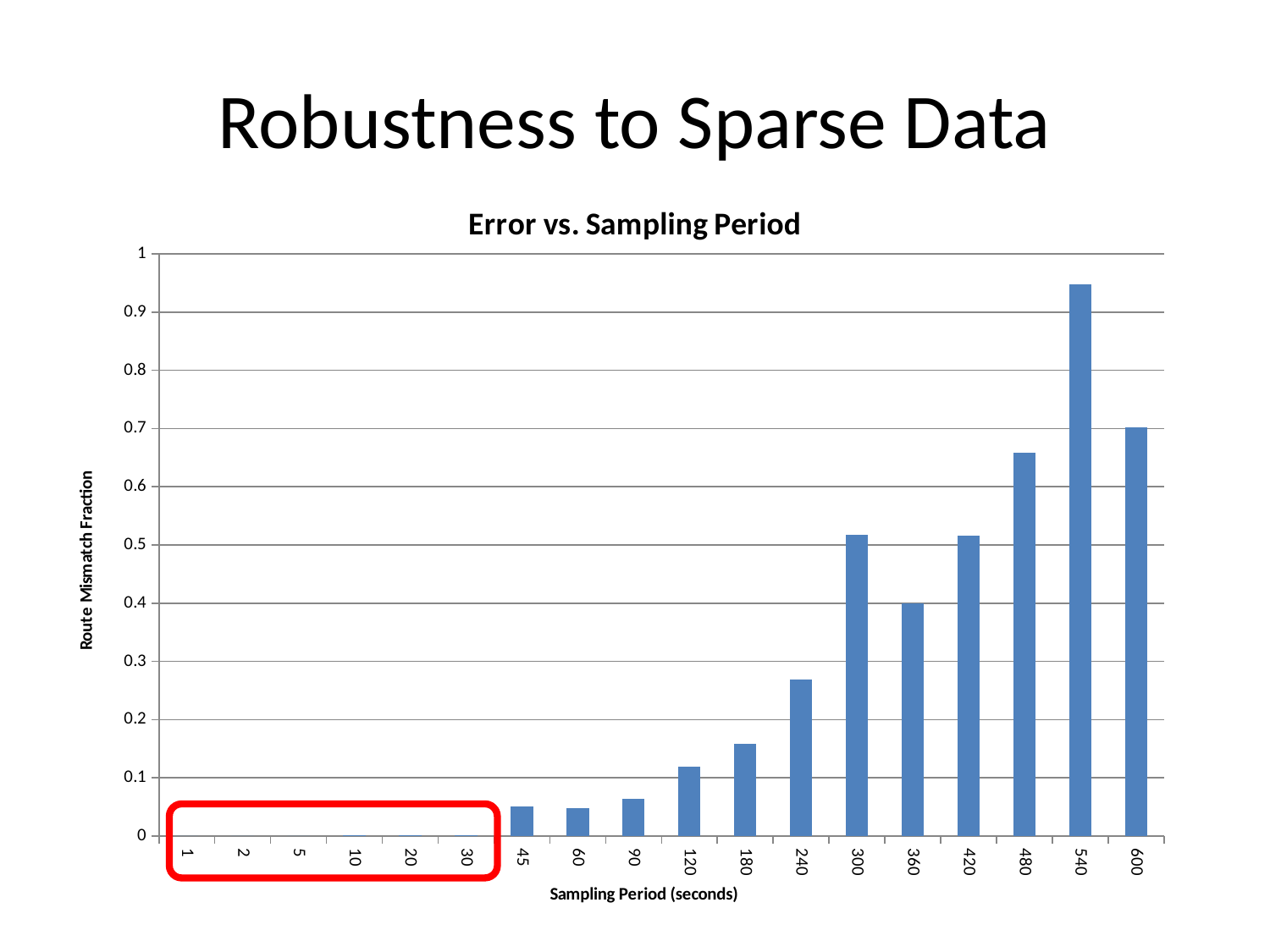
What is the label of the vertical axis? Route Mismatch Fraction Is the route mismatch fraction for a sampling period of 540 greater or less than 0.9? greater What kind of chart is shown on the slide? bar chart Is the route mismatch fraction for a sampling period of 360 greater or less than 0.5? less How many sampling period categories are shown on the x axis? 18 Which sampling period has the highest route mismatch fraction? 540 Is the route mismatch fraction for a sampling period of 480 greater or less than 0.6? greater Does the route mismatch fraction generally rise or fall as the sampling period increases? rise What is the title of the chart? Error vs. Sampling Period Which has a higher route mismatch fraction, a sampling period of 540 or 600? 540 Which has a higher route mismatch fraction, a sampling period of 300 or 360? 300